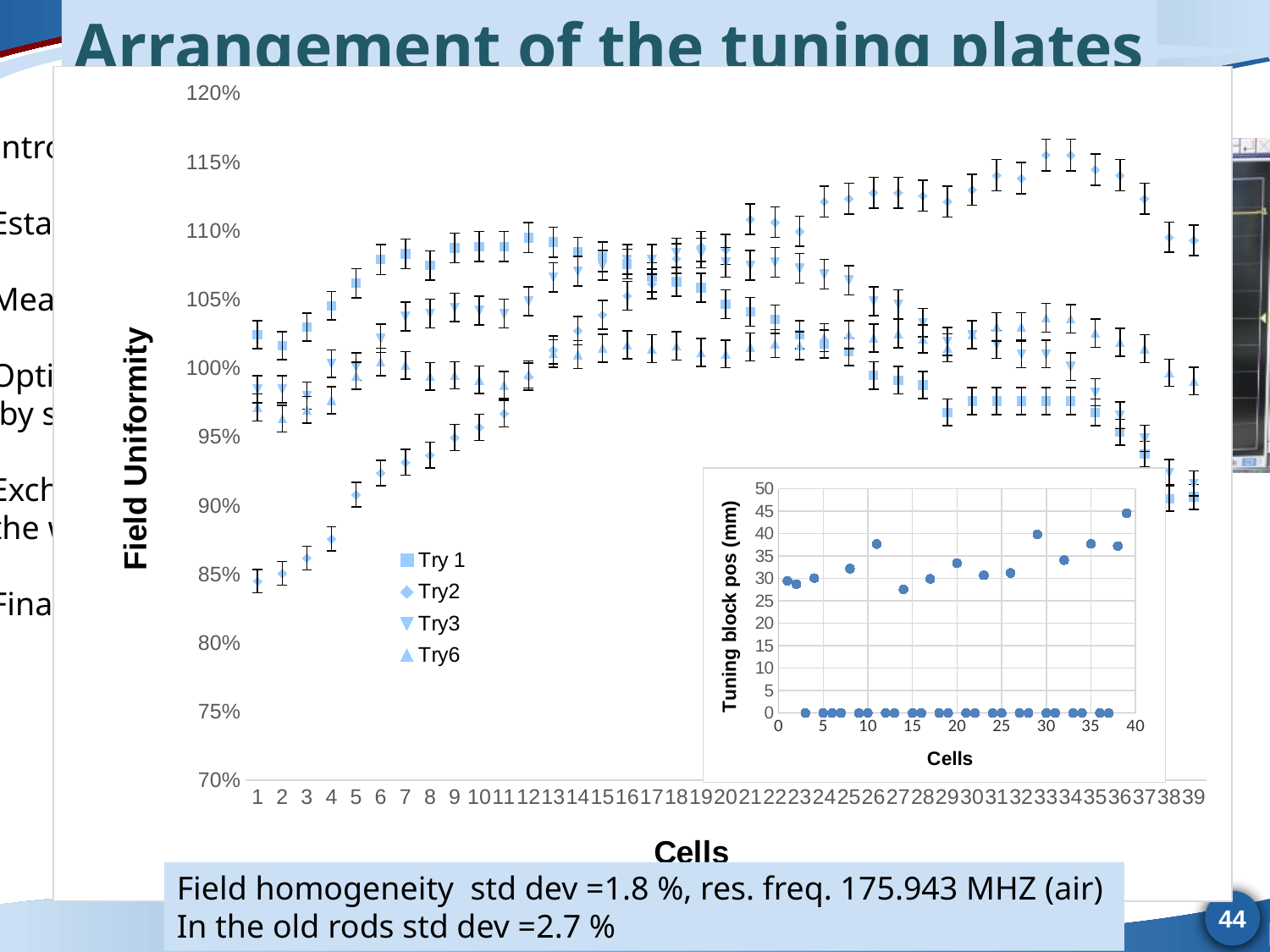
In the large Field Uniformity chart, how many cells are shown on the x axis? 39 In the large Field Uniformity chart, what are the names of the series in the legend? Try 1, Try2, Try3, Try6 What kind of chart is the inset Tuning block pos (mm) chart? scatter chart In the inset Tuning block pos (mm) chart, is the value at cell 39 greater or less than 40? greater In the large Field Uniformity chart, what is the title of the y axis? Field Uniformity In the large Field Uniformity chart, is the value for Try2 at cell 33 greater or less than 110%? greater In the large Field Uniformity chart, is the value for Try 1 at cell 1 greater or less than 100%? greater In the large Field Uniformity chart, how many series does the legend list? 4 In the large Field Uniformity chart, do the Try 1 values rise or fall from cell 1 to cell 12? rise What kind of chart is the large Field Uniformity chart? scatter chart